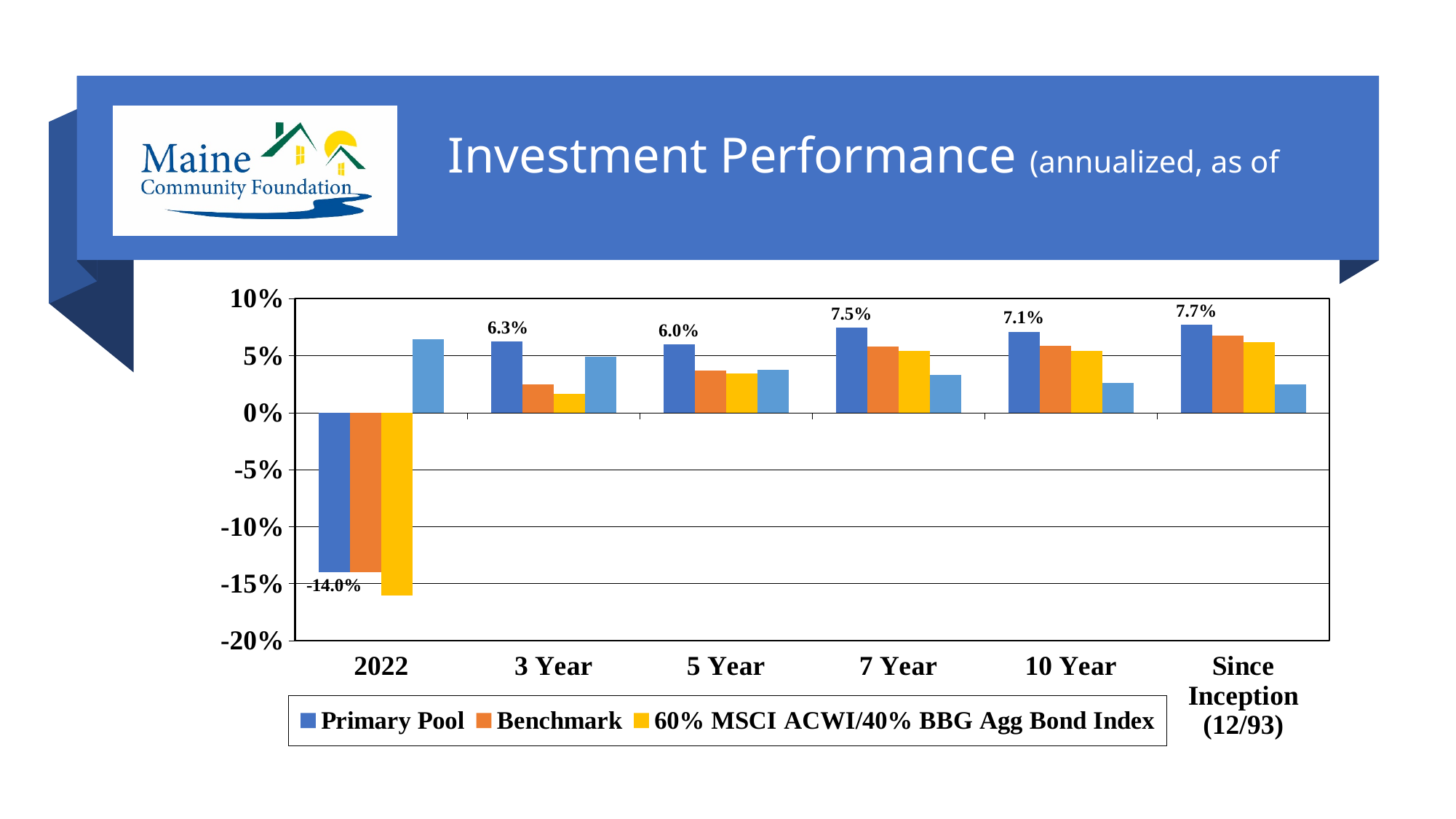
What is the Primary Pool value for Since Inception (12/93)? 7.7% How many categories are shown on the x axis? 6 What is the Primary Pool value for 7 Year? 7.5% Which category has the lowest Primary Pool value? 2022 Which is larger, the Primary Pool value for 3 Year or for 10 Year? 10 Year Is the 60% MSCI ACWI/40% BBG Agg Bond Index value for 2022 greater or less than -15%? less What kind of chart is shown on the slide? bar chart What is the difference between the Primary Pool values for 7 Year and 5 Year? 1.5% Which category has the highest Primary Pool value? Since Inception (12/93) Is the Benchmark value for 2022 greater or less than -10%? less What is the Primary Pool value for 2022? -14.0% How many series does the legend list? 3